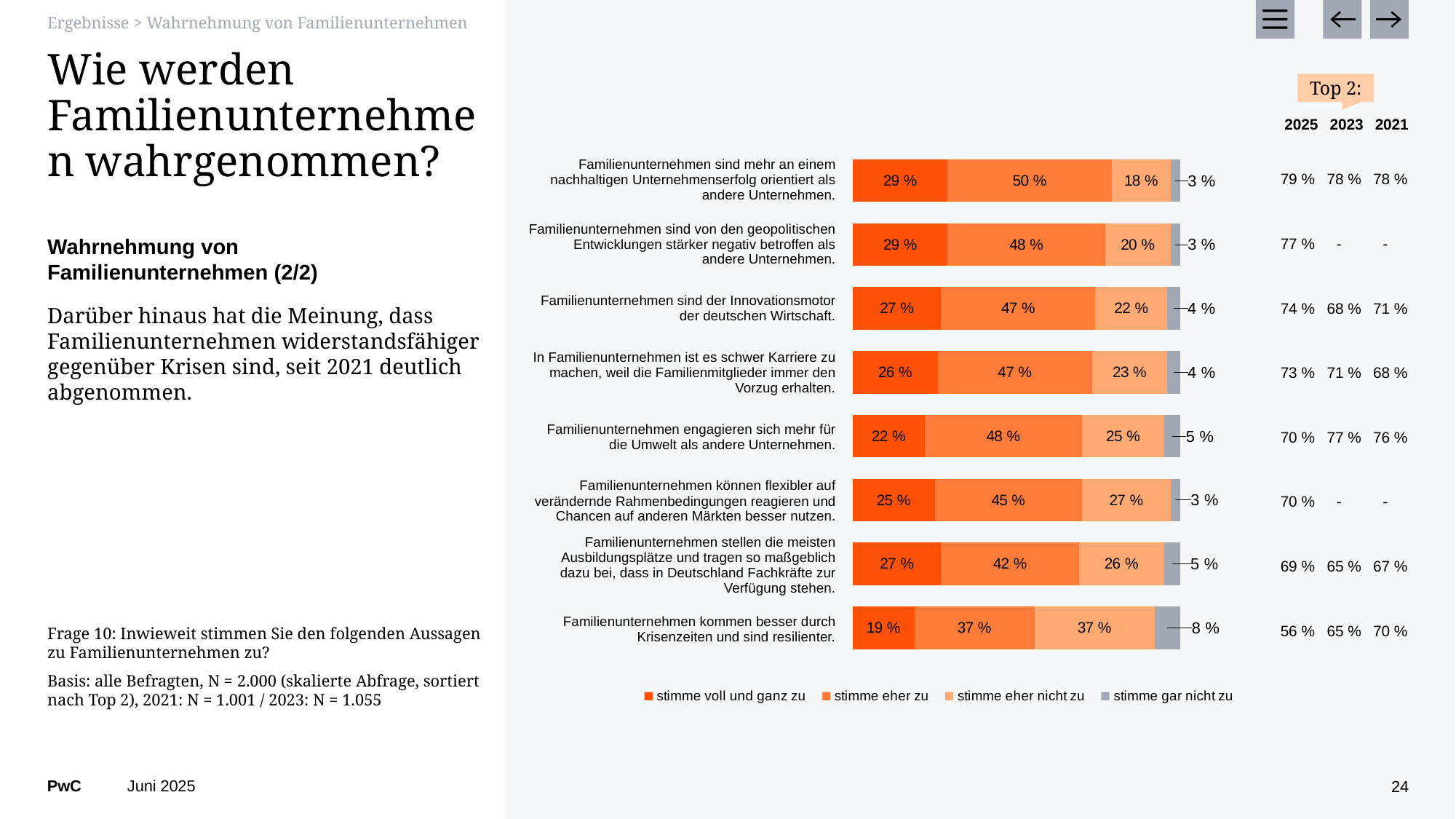
What is the difference between the "stimme eher zu" values for the statement about nachhaltigen Unternehmenserfolg and the statement about Krisenzeiten/resilienter? 13 % What is the "stimme eher zu" value for the statement "Familienunternehmen sind mehr an einem nachhaltigen Unternehmenserfolg orientiert als andere Unternehmen"? 50 % How many series does the chart legend list? 4 How many statements (categories) are plotted in the chart? 8 What is the "stimme gar nicht zu" value for the statement "Familienunternehmen kommen besser durch Krisenzeiten und sind resilienter"? 8 % What is the combined share of "stimme voll und ganz zu" and "stimme eher zu" for the statement "In Familienunternehmen ist es schwer Karriere zu machen, weil die Familienmitglieder immer den Vorzug erhalten"? 73 % What is the "stimme voll und ganz zu" value for the statement "Familienunternehmen sind der Innovationsmotor der deutschen Wirtschaft"? 27 % Which legend entry is shown in grey? stimme gar nicht zu What kind of chart is shown on the slide? stacked bar chart Which is larger: the "stimme eher nicht zu" value for the statement about Umwelt engagement or for the statement about Innovationsmotor? Umwelt engagement (25 %) Which statement has the lowest "stimme voll und ganz zu" share? Familienunternehmen kommen besser durch Krisenzeiten und sind resilienter